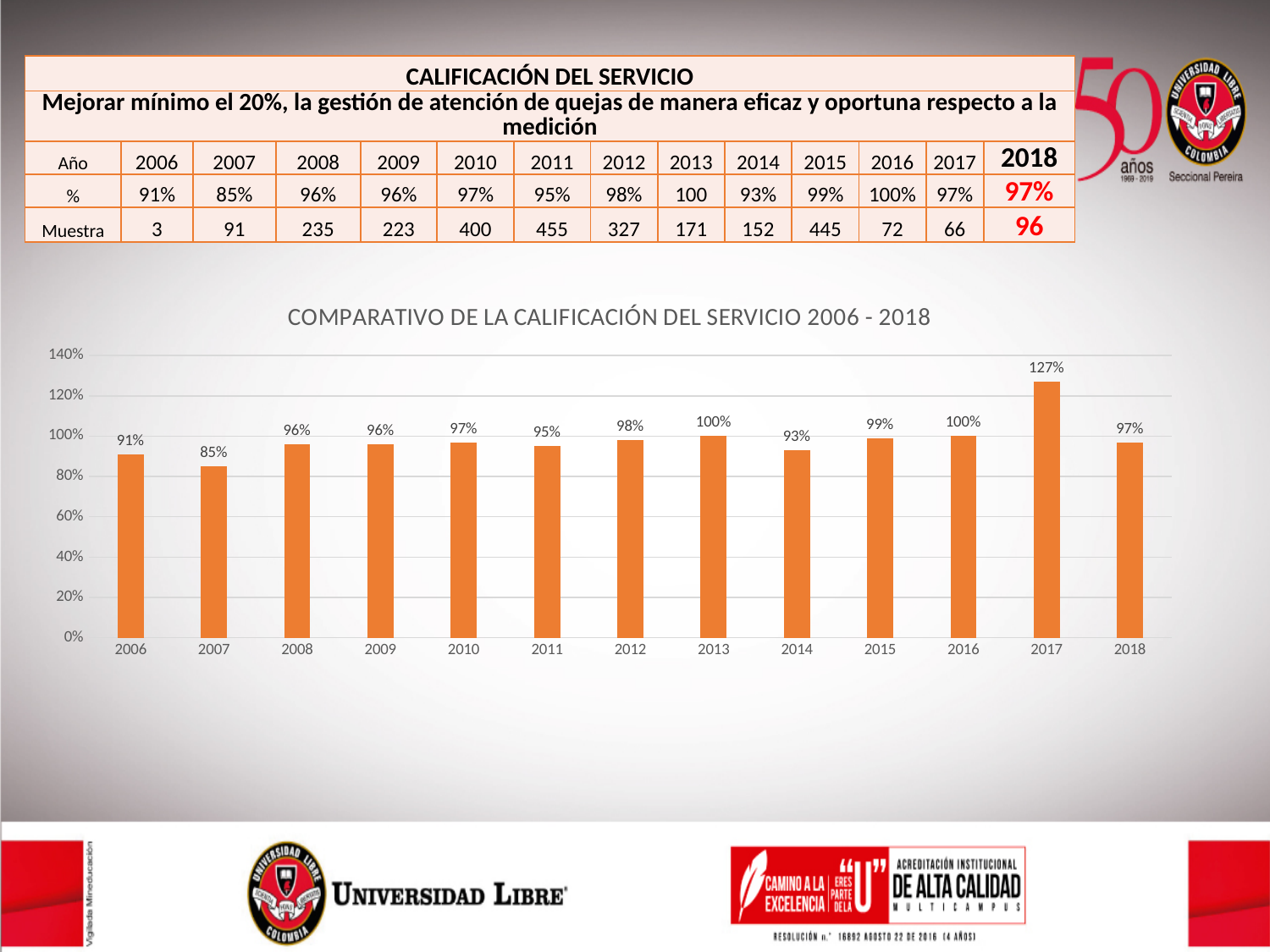
What is the value for 2007 in the chart? 85% What is the difference between the values for 2006 and 2007 in the chart? 6% What is the value for 2014 in the chart? 93% What is the title of the chart? COMPARATIVO DE LA CALIFICACIÓN DEL SERVICIO 2006 - 2018 Which is larger in the chart, the value for 2012 or the value for 2014? 2012 What is the value for 2017 in the chart? 127% What kind of chart is shown on the slide? bar chart How many years are shown on the x axis of the chart? 13 What is the difference between the values for 2017 and 2018 in the chart? 30% Is the value for 2007 in the chart greater or less than 100%? less Which year has the lowest value in the chart? 2007 Which year has the highest value in the chart? 2017